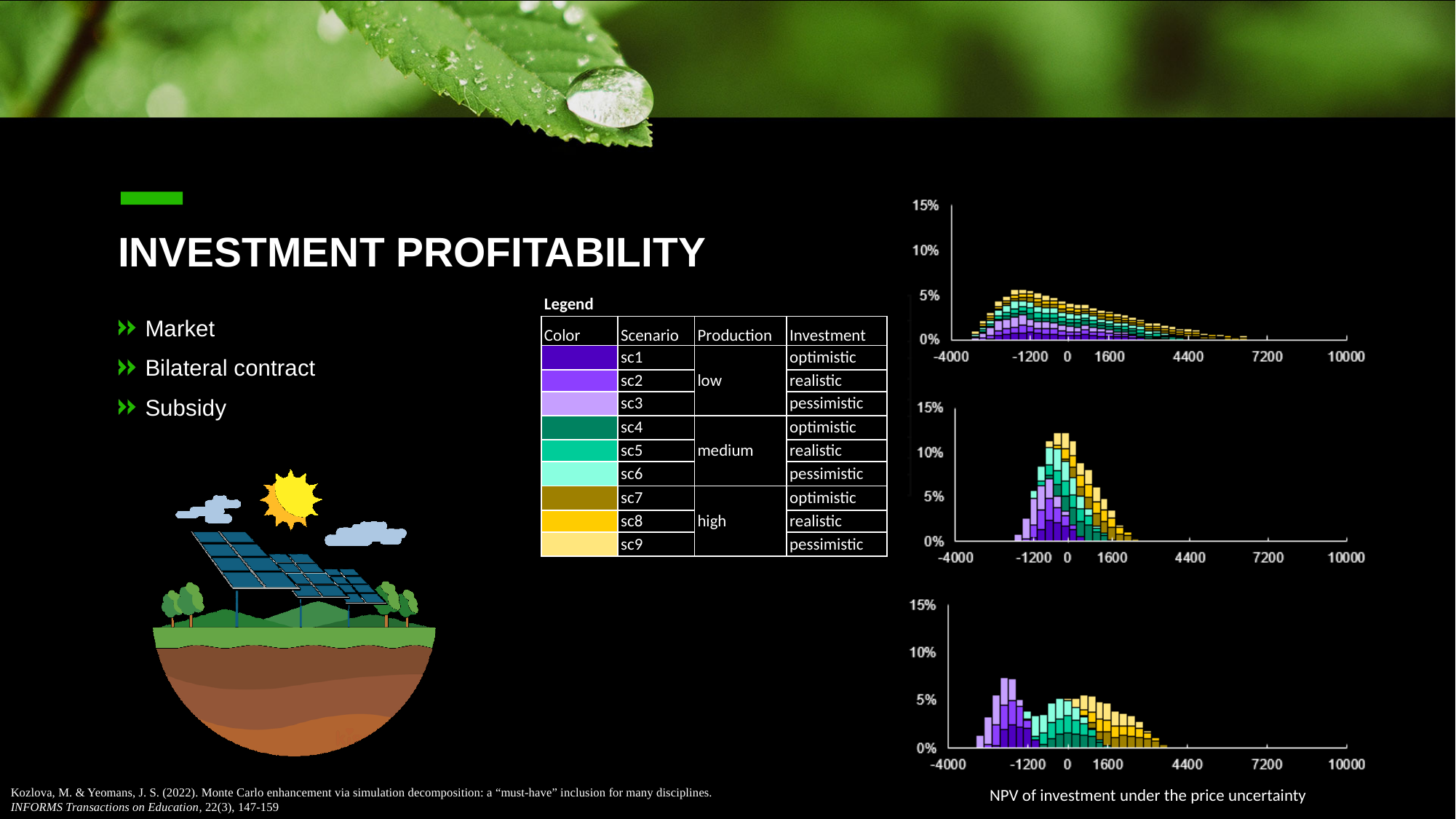
In the bottom chart, is the tallest bar greater or less than 10%? less What is the caption below the three charts? NPV of investment under the price uncertainty What is the highest value shown on the x axis of the bottom chart? 10000 How many scenarios does the legend table list? 9 What kind of chart is shown in the top chart on the right of the slide? bar chart How many charts are shown on the right side of the slide? 3 In the bottom chart, is the tallest bar greater or less than 5%? greater According to the legend, which production level does scenario sc8 correspond to? high In the top chart, is the tallest bar greater or less than 10%? less Which chart has the taller peak, the top chart or the middle chart? the middle chart